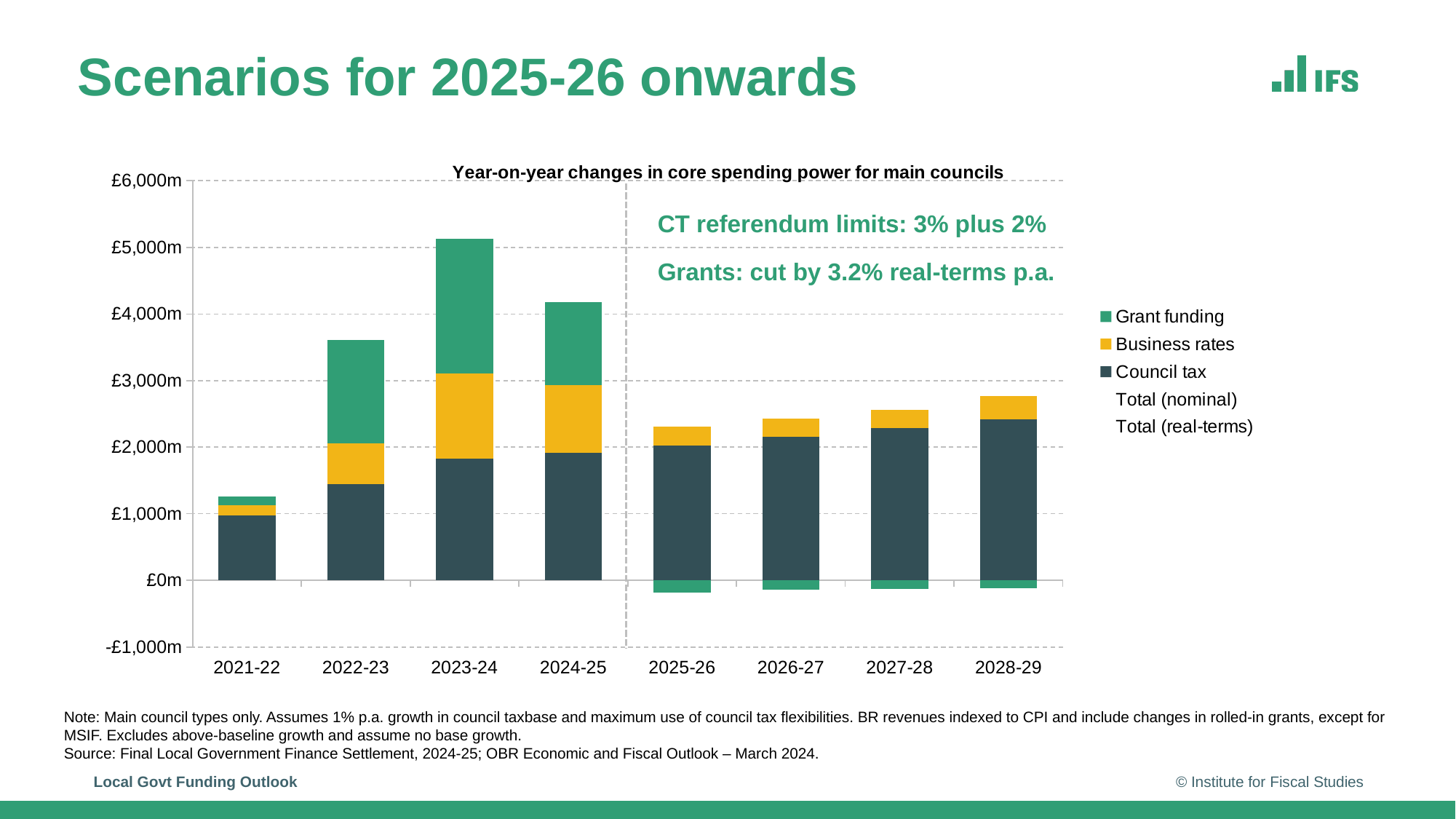
How many entries does the chart's legend list? 5 How many years (categories) are shown on the x axis of the chart? 8 Is the Council tax value for 2028-29 greater or less than £2,000m? greater Do the stacked bars rise or fall from 2025-26 to 2028-29? Rise Is the Grant funding value for 2025-26 greater or less than £0m? less Is the total stacked bar for 2021-22 greater or less than £2,000m? less Which year has the smallest stacked bar in the chart? 2021-22 Which year has the larger stacked bar, 2022-23 or 2025-26? 2022-23 What kind of chart is shown on the slide? Stacked bar chart What is the title of the chart? Year-on-year changes in core spending power for main councils Which year has the tallest stacked bar in the chart? 2023-24